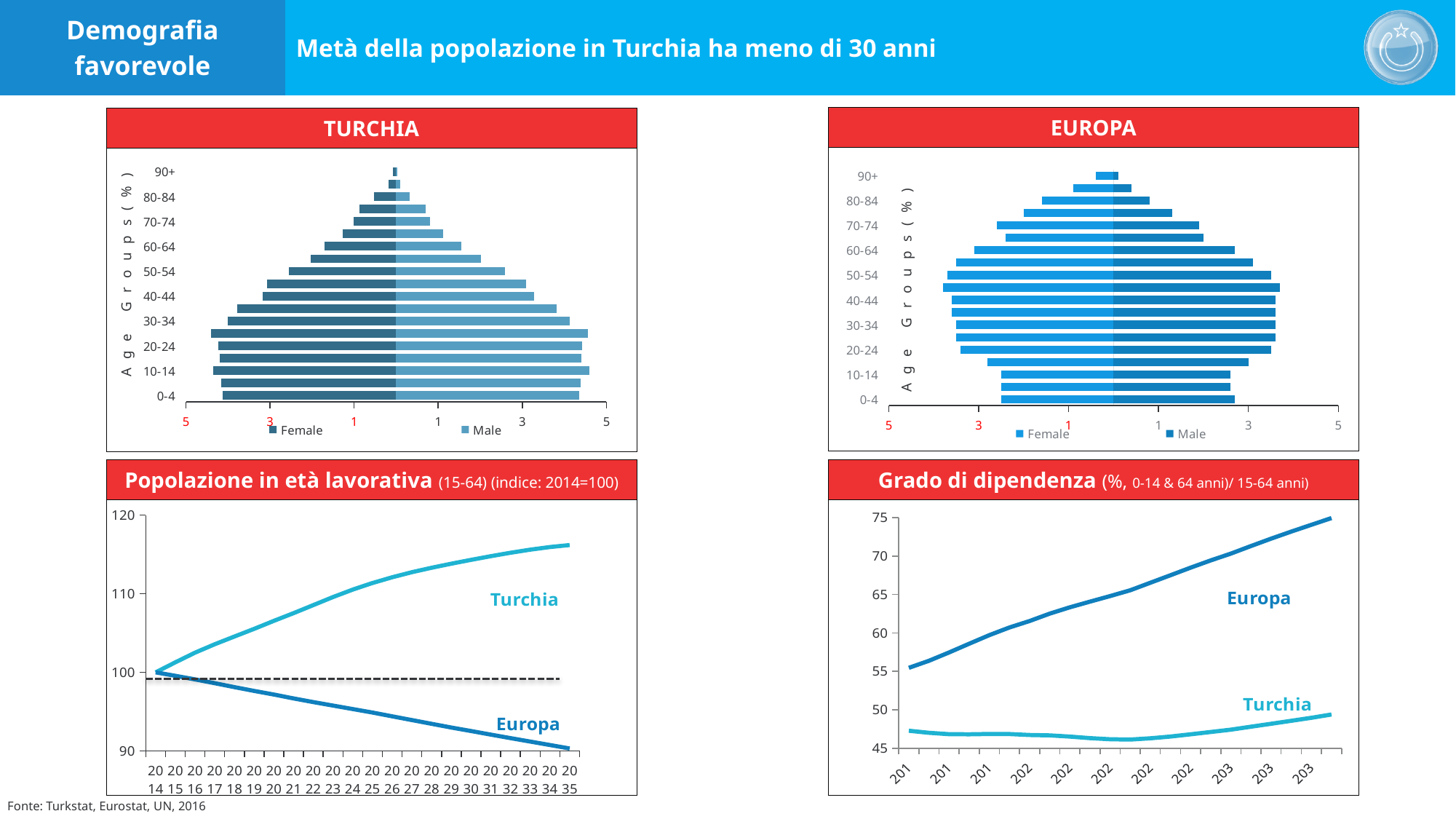
What are the legend entries of the EUROPA chart? Female, Male In the 'Popolazione in età lavorativa' chart, does the Europa line rise or fall from 2014 to 2035? fall In the 'Popolazione in età lavorativa' chart, which line is higher in 2035, Turchia or Europa? Turchia In the 'Popolazione in età lavorativa' chart, is the value for Turchia in 2035 greater or less than 110? greater How many series does the legend of the TURCHIA chart list? 2 In the 'Popolazione in età lavorativa' chart, does the Turchia line rise or fall from 2014 to 2035? rise In the 'Popolazione in età lavorativa' chart, what is the index value for Turchia in 2014? 100 In the 'Grado di dipendenza' chart, is the value for Europa at the end of the period greater or less than 70? greater In the 'Popolazione in età lavorativa' chart, is the value for Europa in 2035 greater or less than 95? less How many years are shown on the x axis of the 'Popolazione in età lavorativa' chart? 22 In the 'Grado di dipendenza' chart, does the Europa line rise or fall over the period shown? rise What kind of chart is the TURCHIA chart? bar chart